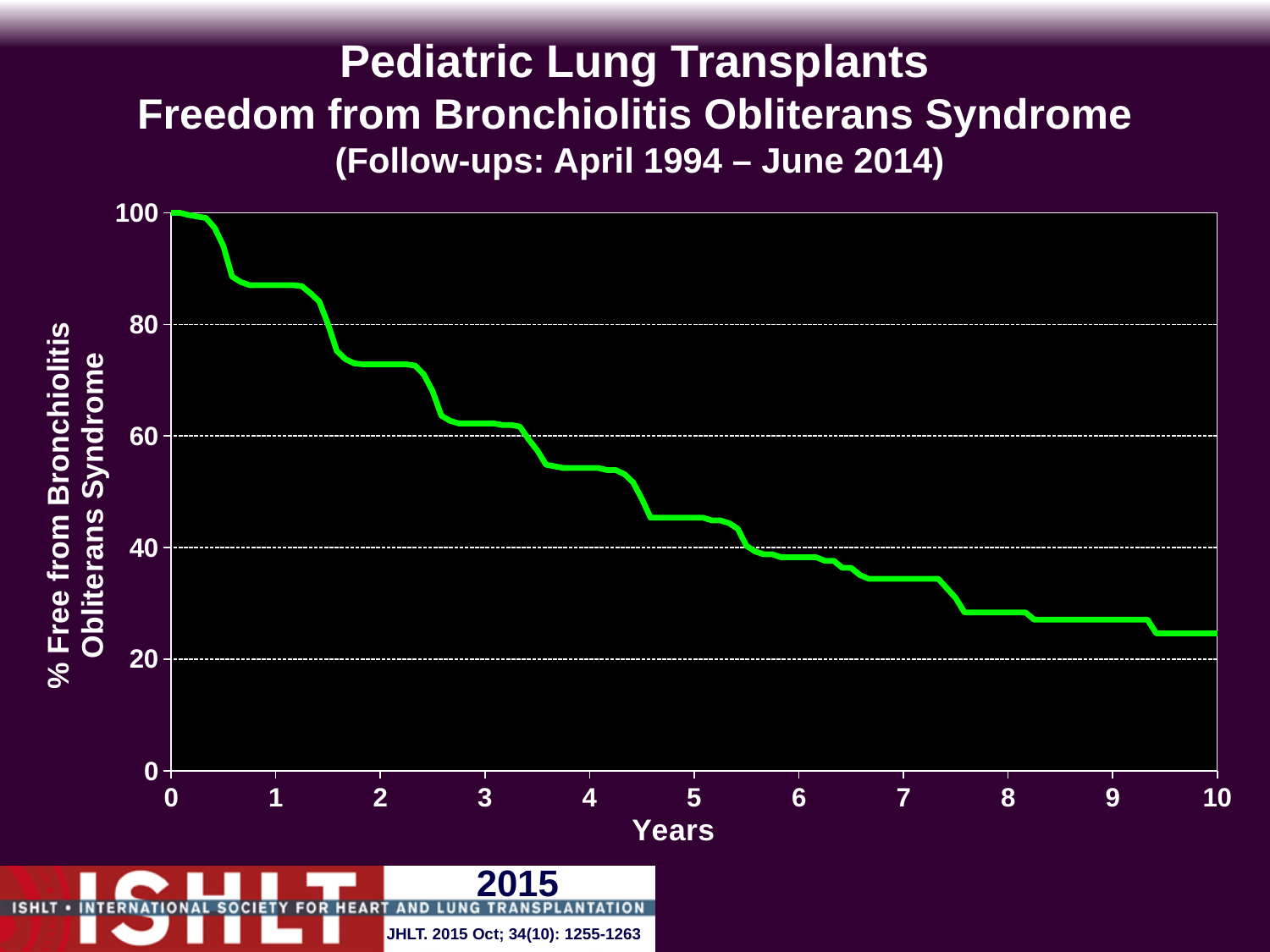
Do the values on the chart rise or fall as the years increase? fall Is the value at year 7 greater or less than 40? less Is the value at year 1 greater or less than 80? greater Is the value at year 2 greater or less than 80? less What is the % free from bronchiolitis obliterans syndrome at year 0? 100 What kind of chart is shown on the slide? line chart Which is larger, the value at year 3 or the value at year 8? year 3 What is the label of the x axis? Years What follow-up period is given in the chart title? April 1994 – June 2014